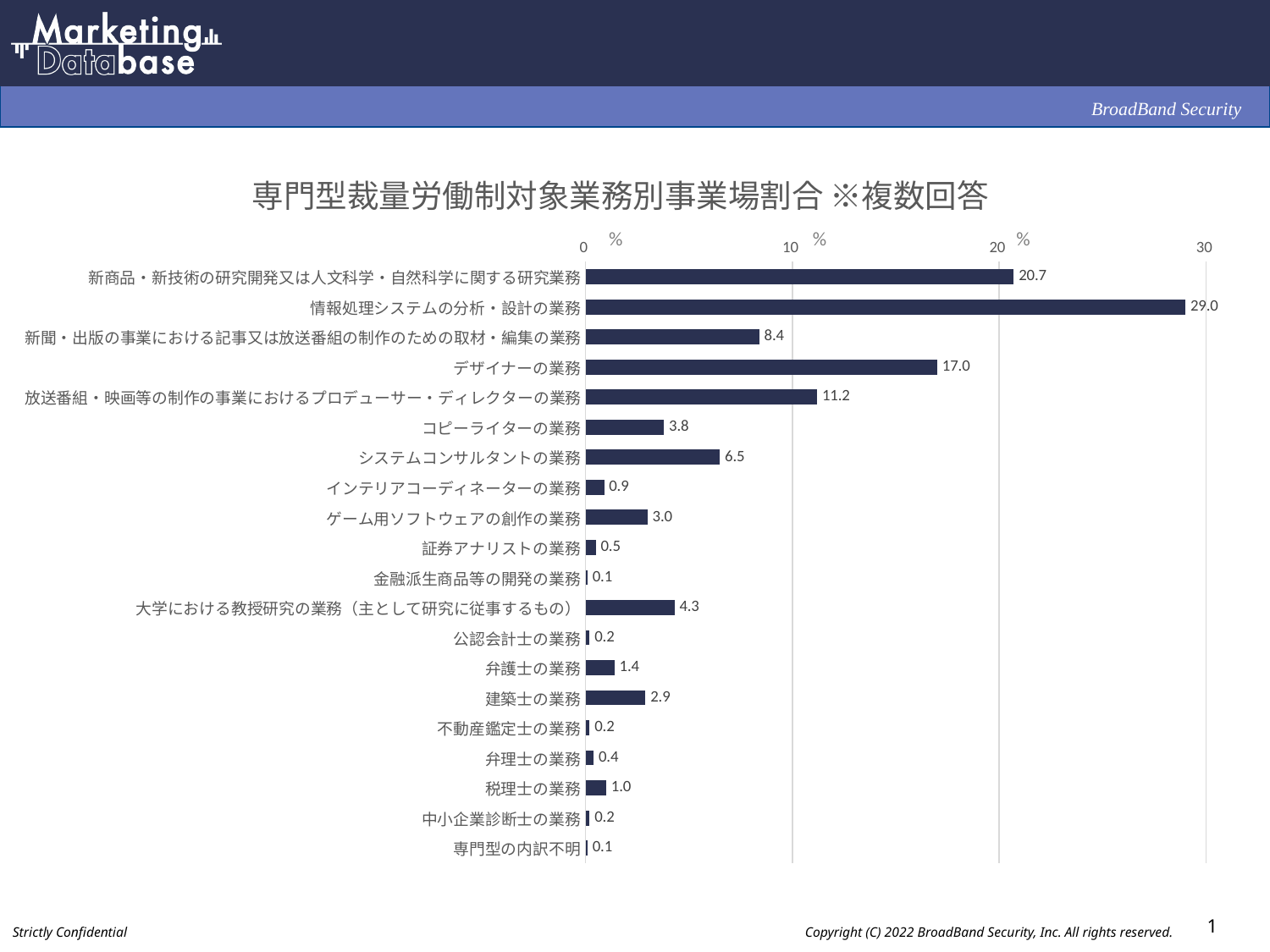
What is the value for 情報処理システムの分析・設計の業務? 29.0 Which category has the highest value? 情報処理システムの分析・設計の業務 What is the value for 建築士の業務? 2.9 What is the title of the chart? 専門型裁量労働制対象業務別事業場割合 ※複数回答 What is the difference between the values for 情報処理システムの分析・設計の業務 and 新商品・新技術の研究開発又は人文科学・自然科学に関する研究業務? 8.3 What is the value for デザイナーの業務? 17.0 Which is larger, the value for コピーライターの業務 or the value for ゲーム用ソフトウェアの創作の業務? コピーライターの業務 Is the value for 新聞・出版の事業における記事又は放送番組の制作のための取材・編集の業務 greater or less than 10? less What is the difference between the values for デザイナーの業務 and 放送番組・映画等の制作の事業におけるプロデューサー・ディレクターの業務? 5.8 What type of chart is shown on the slide? bar chart What is the value for システムコンサルタントの業務? 6.5 How many categories are shown in the chart? 20